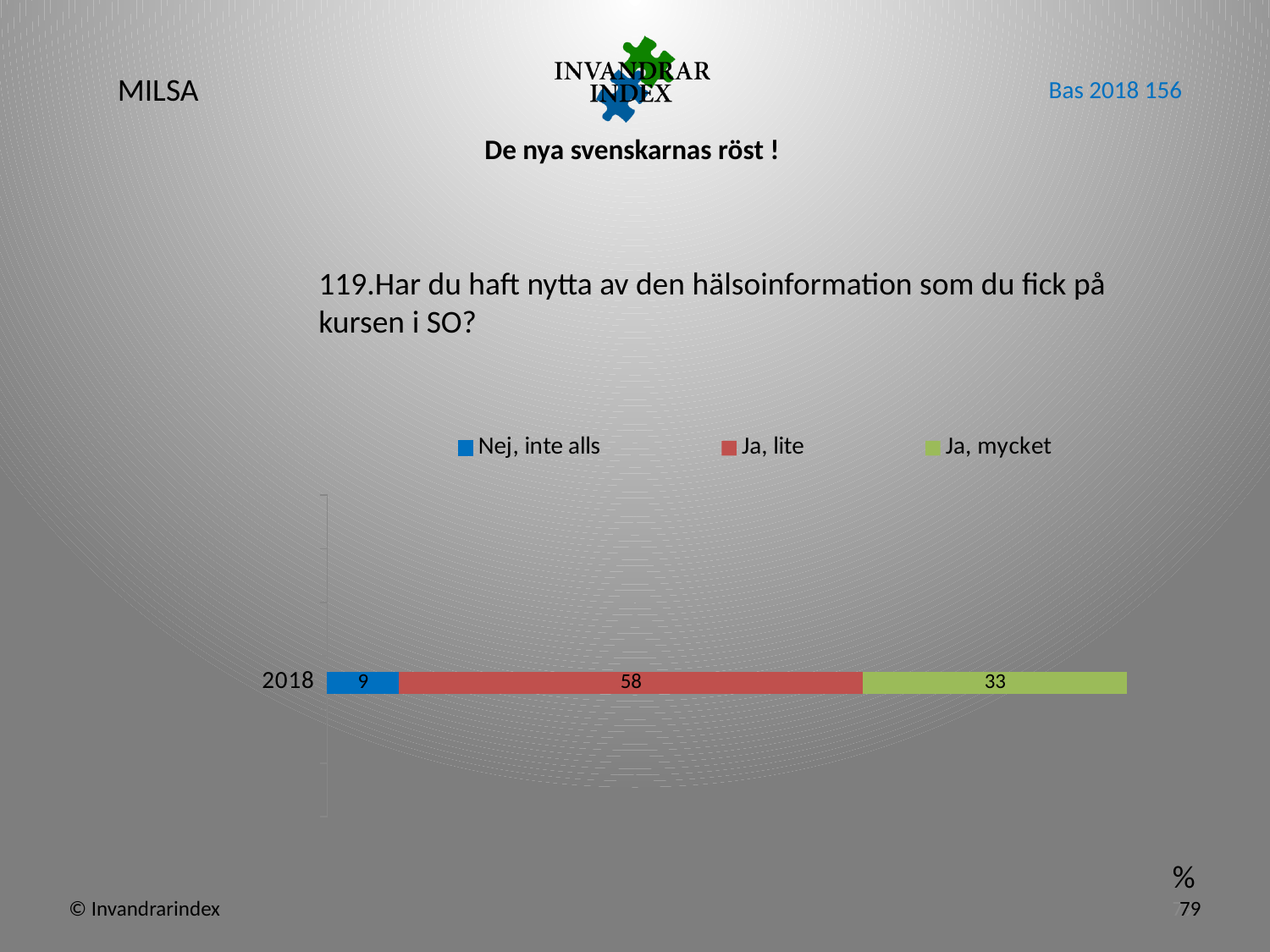
What is the value for "Nej, inte alls" in 2018? 9 Which series has the highest value in 2018? Ja, lite What kind of chart is shown on the slide? Stacked bar chart Which is larger in 2018: "Ja, mycket" or "Nej, inte alls"? Ja, mycket What colour represents "Ja, lite" in the chart? Red How many categories are shown on the chart? 1 What is the total of the stacked bar for 2018? 100 What is the value for "Ja, lite" in 2018? 58 What is the value for "Ja, mycket" in 2018? 33 How many series does the legend list? 3 Which series has the lowest value in 2018? Nej, inte alls What is the difference between the values for "Ja, lite" and "Ja, mycket" in 2018? 25